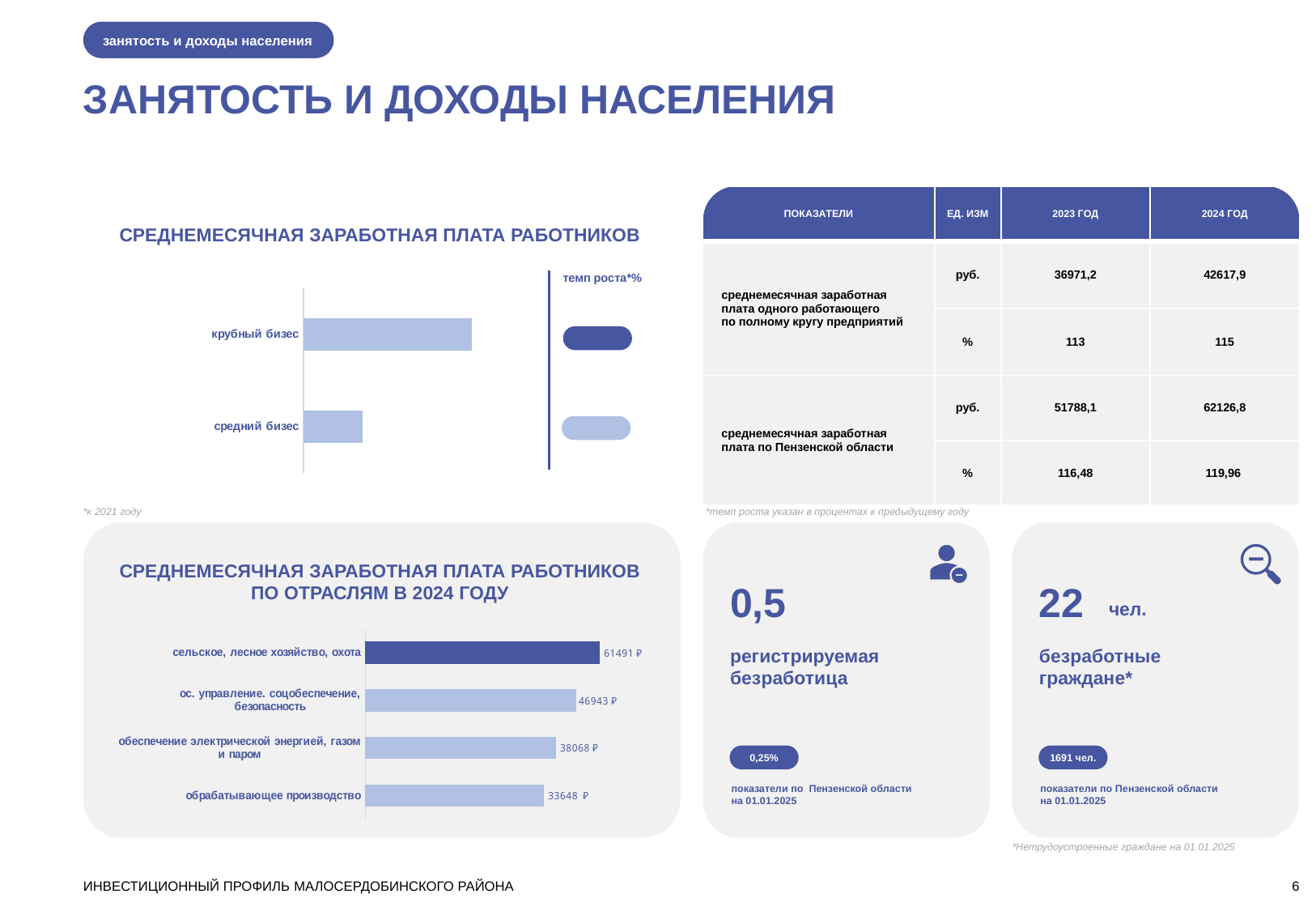
In the chart 'Среднемесячная заработная плата работников по отраслям в 2024 году', what is the difference between 'сельское, лесное хозяйство, охота' and 'обрабатывающее производство'? 27843 ₽ In the chart 'Среднемесячная заработная плата работников по отраслям в 2024 году', what is the value for 'обрабатывающее производство'? 33648 ₽ In the chart 'Среднемесячная заработная плата работников по отраслям в 2024 году', what is the value for 'обеспечение электрической энергией, газом и паром'? 38068 ₽ In the chart 'Среднемесячная заработная плата работников по отраслям в 2024 году', which is larger: 'ос. управление, соцобеспечение, безопасность' or 'обрабатывающее производство'? ос. управление, соцобеспечение, безопасность In the chart 'Среднемесячная заработная плата работников по отраслям в 2024 году', which category has the highest value? сельское, лесное хозяйство, охота In the top-left chart 'Среднемесячная заработная плата работников', which bar is longer: 'крупный бизнес' or 'средний бизнес'? крупный бизнес How many categories are shown in the top-left chart 'Среднемесячная заработная плата работников'? 2 How many categories are shown in the chart 'Среднемесячная заработная плата работников по отраслям в 2024 году'? 4 What kind of chart is 'Среднемесячная заработная плата работников по отраслям в 2024 году'? bar chart In the chart 'Среднемесячная заработная плата работников по отраслям в 2024 году', which category has the lowest value? обрабатывающее производство In the chart 'Среднемесячная заработная плата работников по отраслям в 2024 году', what is the difference between 'ос. управление, соцобеспечение, безопасность' and 'обеспечение электрической энергией, газом и паром'? 8875 ₽ In the chart 'Среднемесячная заработная плата работников по отраслям в 2024 году', what is the value for 'сельское, лесное хозяйство, охота'? 61491 ₽